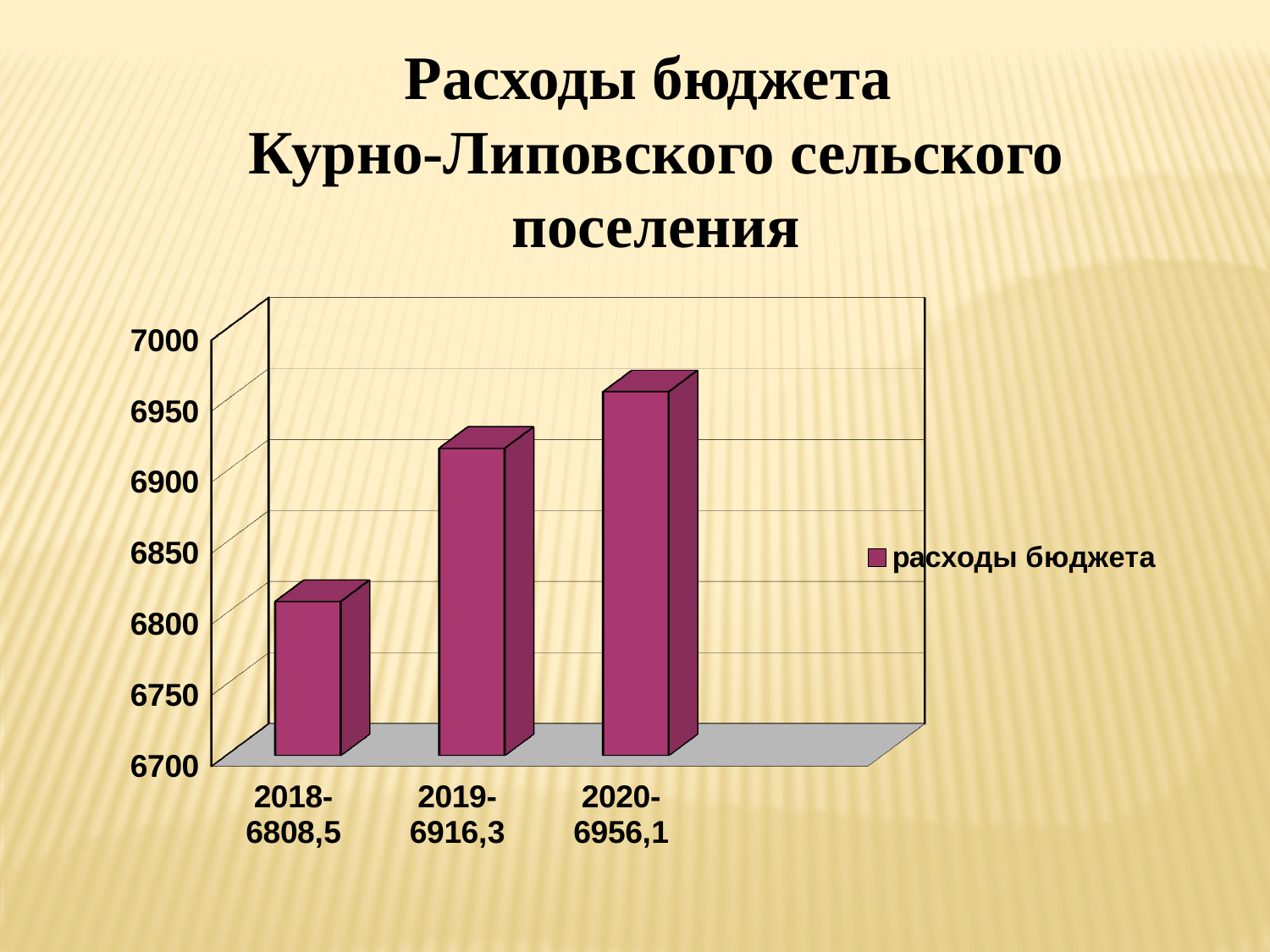
What is the difference between the budget expenditure for 2020 and 2019? 39,8 Which is larger, the budget expenditure for 2019 or for 2020? 2020 What is the budget expenditure value shown for 2020? 6956,1 Which year has the highest budget expenditure? 2020 What is the difference between the budget expenditure for 2019 and 2018? 107,8 What is the budget expenditure value shown for 2018? 6808,5 Which year has the lowest budget expenditure? 2018 How many years (bars) are shown in the chart? 3 Is the value for 2018 greater or less than 6850? less Do the budget expenditure values rise or fall from 2018 to 2020? rise What kind of chart is shown on the slide? bar chart What is the budget expenditure value shown for 2019? 6916,3